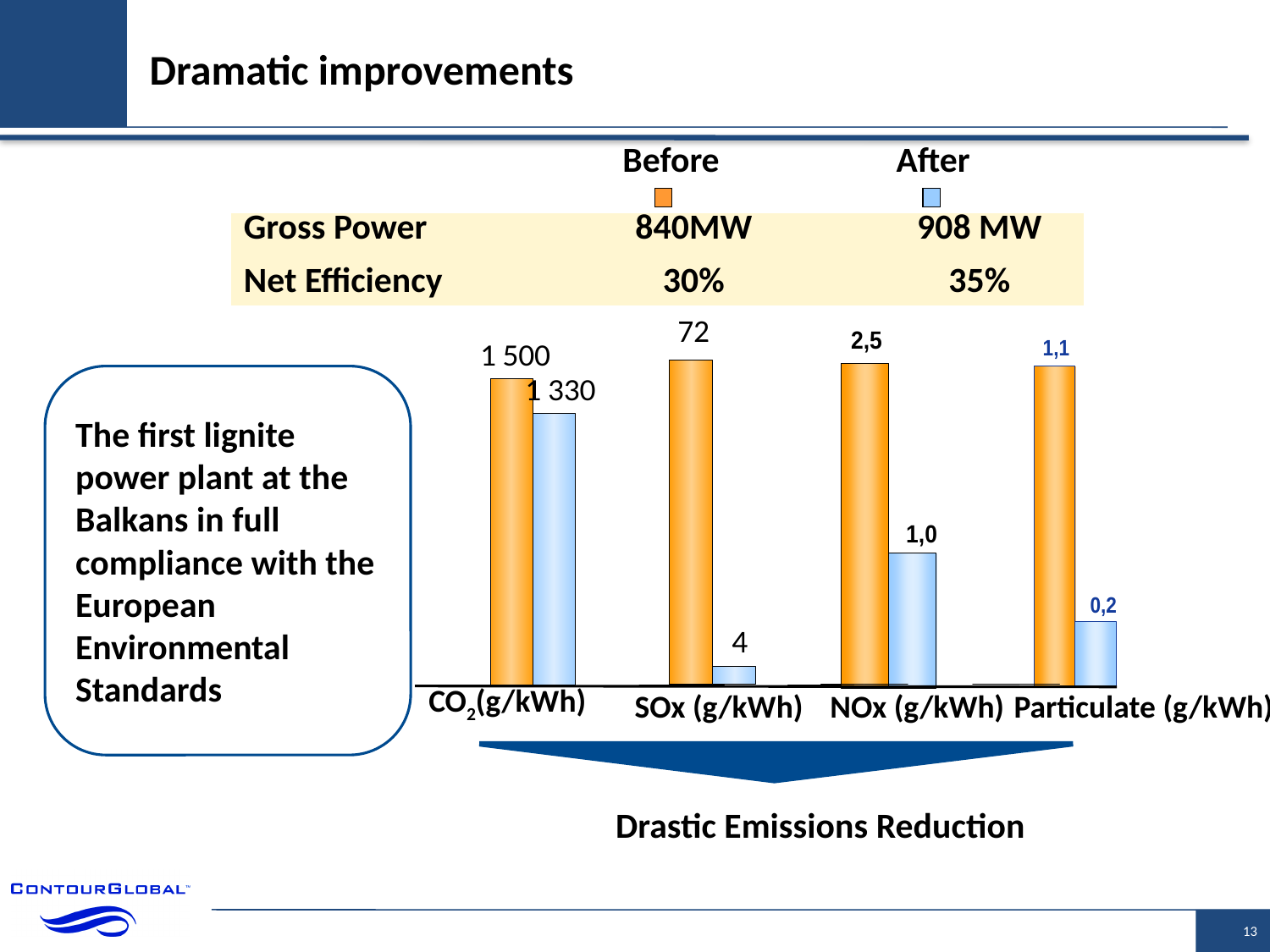
What is the After value for Particulate (g/kWh)? 0,2 What is the difference between the Before and After values for CO2 (g/kWh)? 170 Which colour represents the After series in the chart? Light blue Which is larger for NOx (g/kWh), the Before value or the After value? Before How many series does the chart's legend list? 2 What kind of chart is shown on the slide? Bar chart What is the After value for NOx (g/kWh)? 1,0 How many categories are shown on the x axis of the chart? 4 What is the difference between the Before and After values for SOx (g/kWh)? 68 What is the Before value for SOx (g/kWh)? 72 What is the Before value for Particulate (g/kWh)? 1,1 What is the After value for CO2 (g/kWh)? 1 330